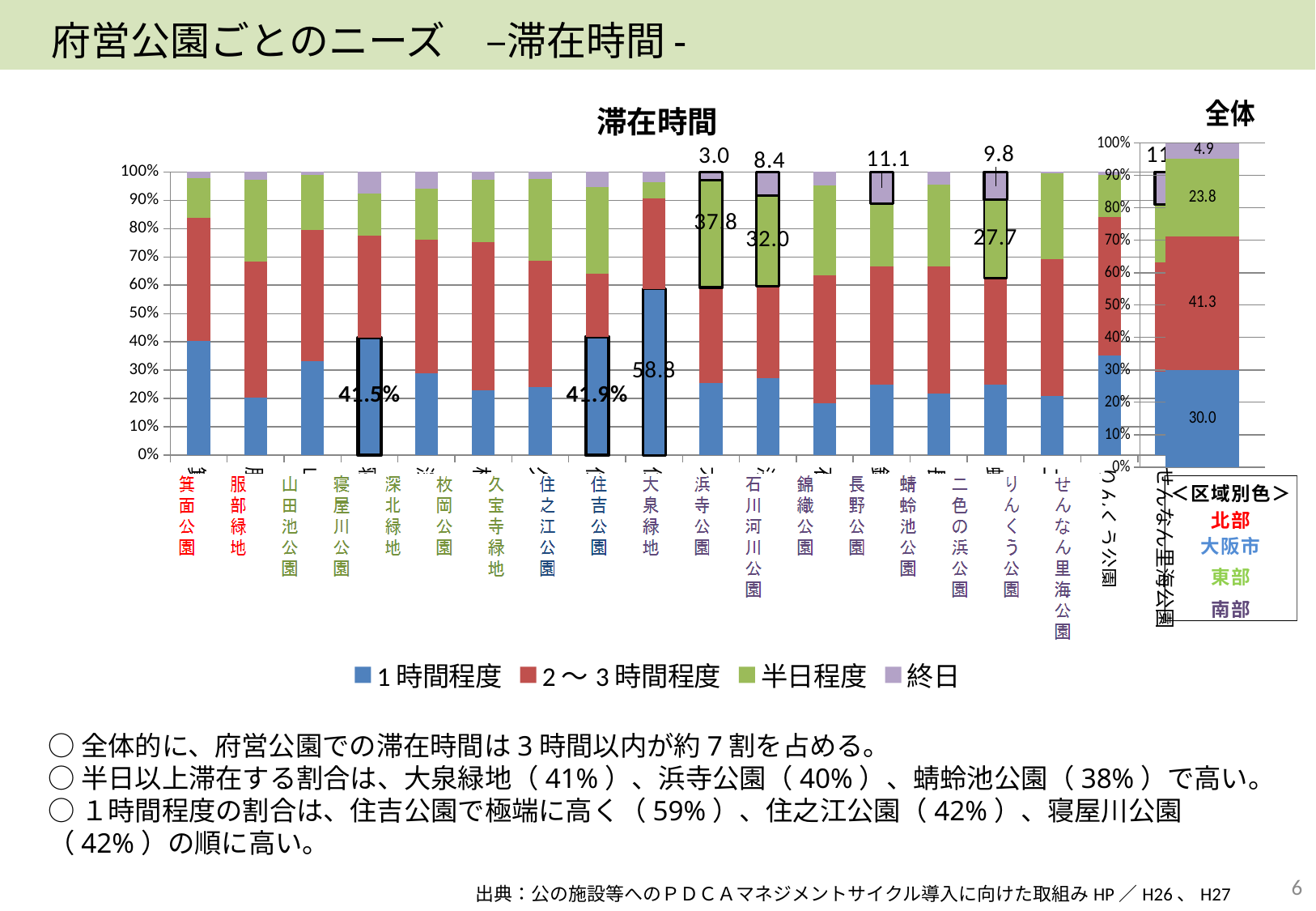
In the 全体 chart, what is the value for 2～3時間程度? 41.3 In the 全体 chart, what is the value for 終日? 4.9 In the 全体 chart, what is the value for 1時間程度? 30.0 In the 全体 chart, what is the difference between the 2～3時間程度 value and the 1時間程度 value? 11.3 In the 全体 chart, what is the value for 半日程度? 23.8 In the 滞在時間 chart, what is the 1時間程度 value for 住吉公園? 58.8 In the 全体 chart, which segment is the smallest? 終日 In the 滞在時間 chart, which colour represents 半日程度 in the legend? green In the 全体 chart, which segment is the largest? 2～3時間程度 How many series does the legend of the 滞在時間 chart list? 4 What kind of chart is the 滞在時間 chart? bar chart In the 滞在時間 chart, what is the 1時間程度 value for 寝屋川公園? 41.5%